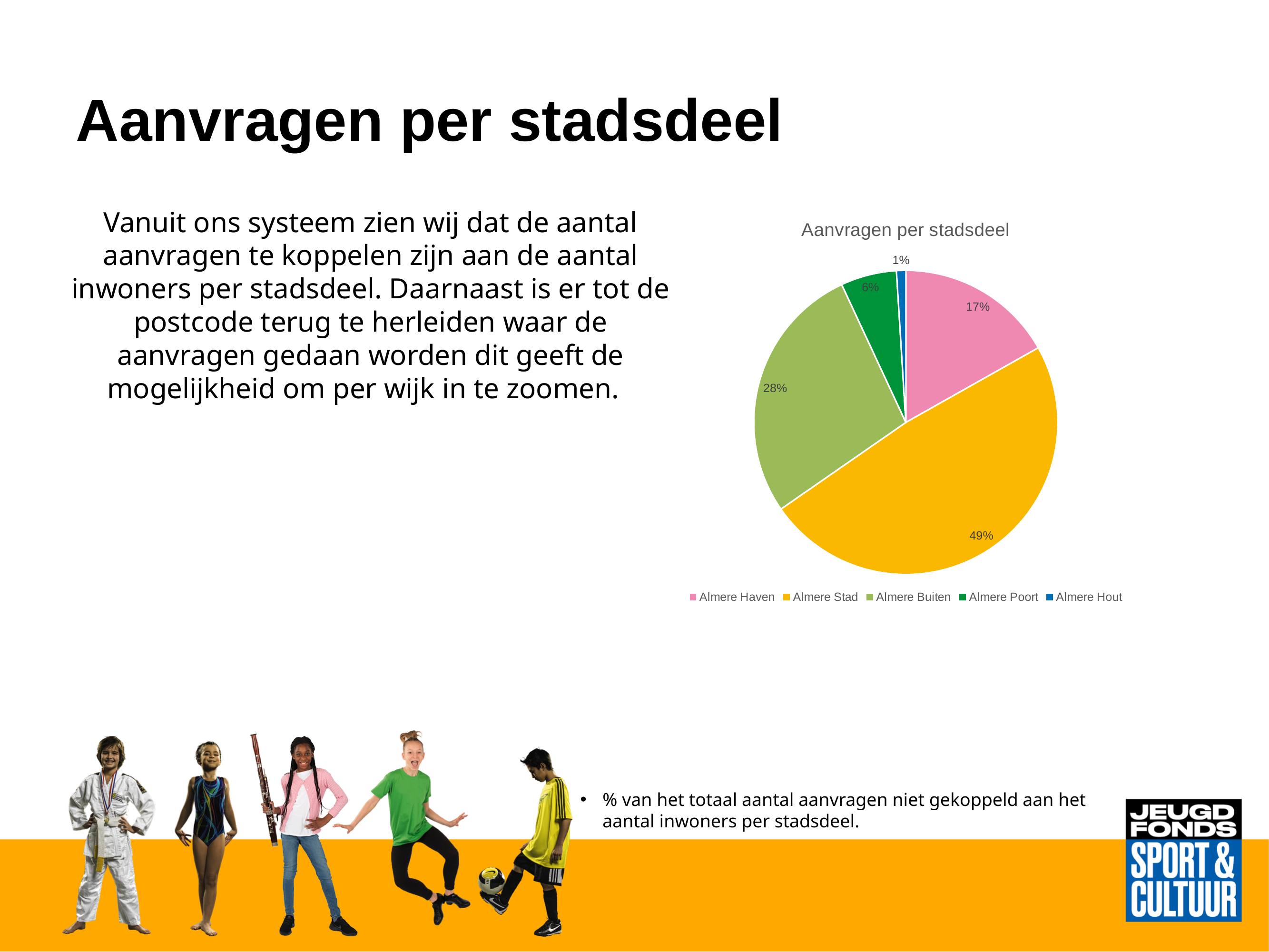
What share of the pie does Almere Hout have? 1% What share of the pie does Almere Haven have? 17% What share of the pie does Almere Buiten have? 28% Which stadsdeel has the largest share of aanvragen? Almere Stad What kind of chart is shown on the slide? pie chart Which has a larger share, Almere Haven or Almere Poort? Almere Haven Which stadsdeel has the smallest share of aanvragen? Almere Hout What is the title of the chart? Aanvragen per stadsdeel How many stadsdelen are shown in the pie chart? 5 What is the difference in percentage points between Almere Stad and Almere Buiten? 21%